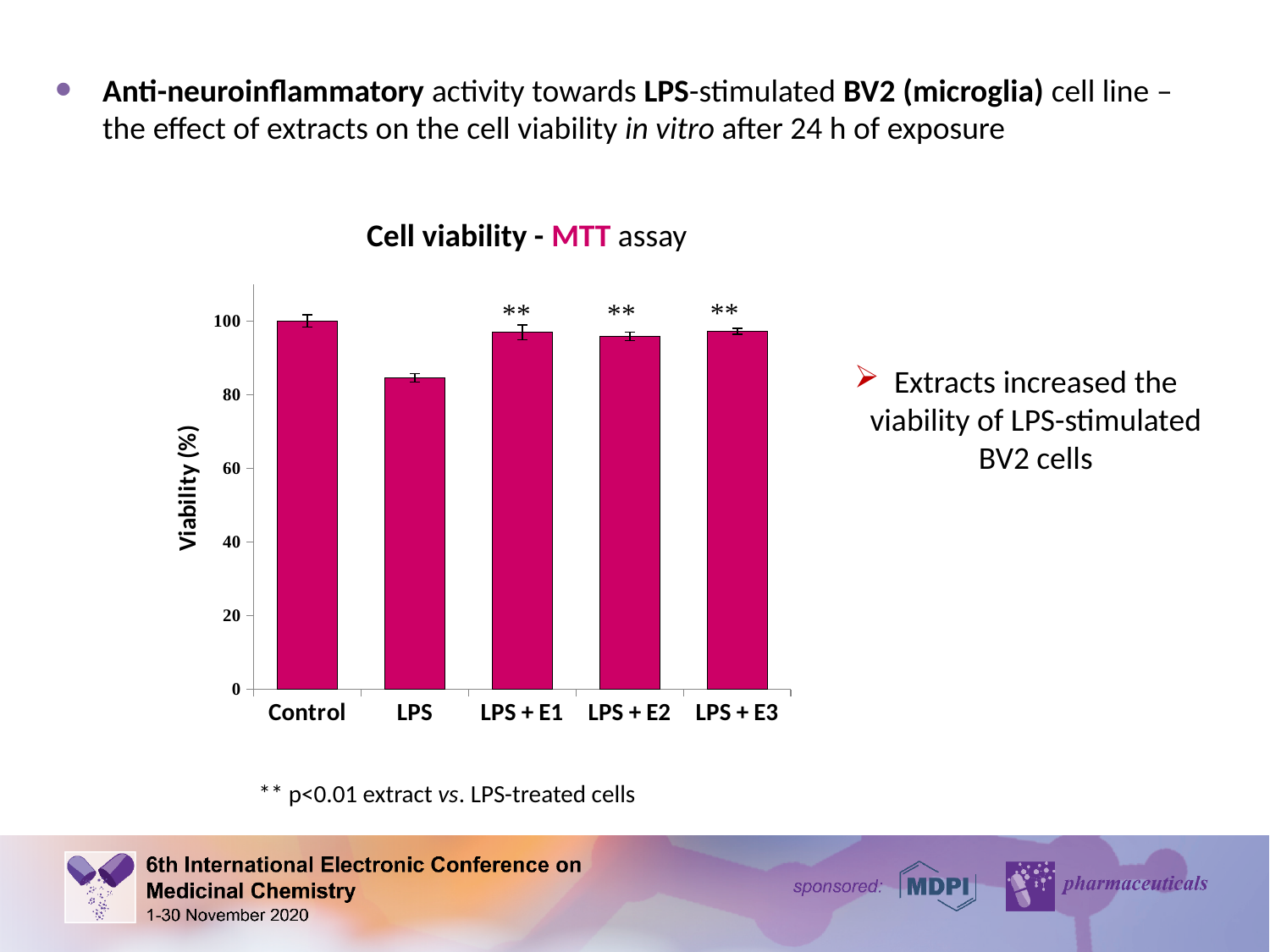
What is the title of the chart? Cell viability - MTT assay What is the viability value for Control? 100 Is the value for LPS + E1 greater or less than 80? greater Which has the higher viability, LPS or LPS + E2? LPS + E2 Is the value for LPS greater or less than 100? less Is the value for LPS + E3 greater or less than 60? greater What kind of chart is shown on the slide? bar chart Which has the higher viability, Control or LPS? Control How many categories are plotted on the x axis of the chart? 5 Which category has the lowest viability in the chart? LPS What is the label of the y axis of the chart? Viability (%)